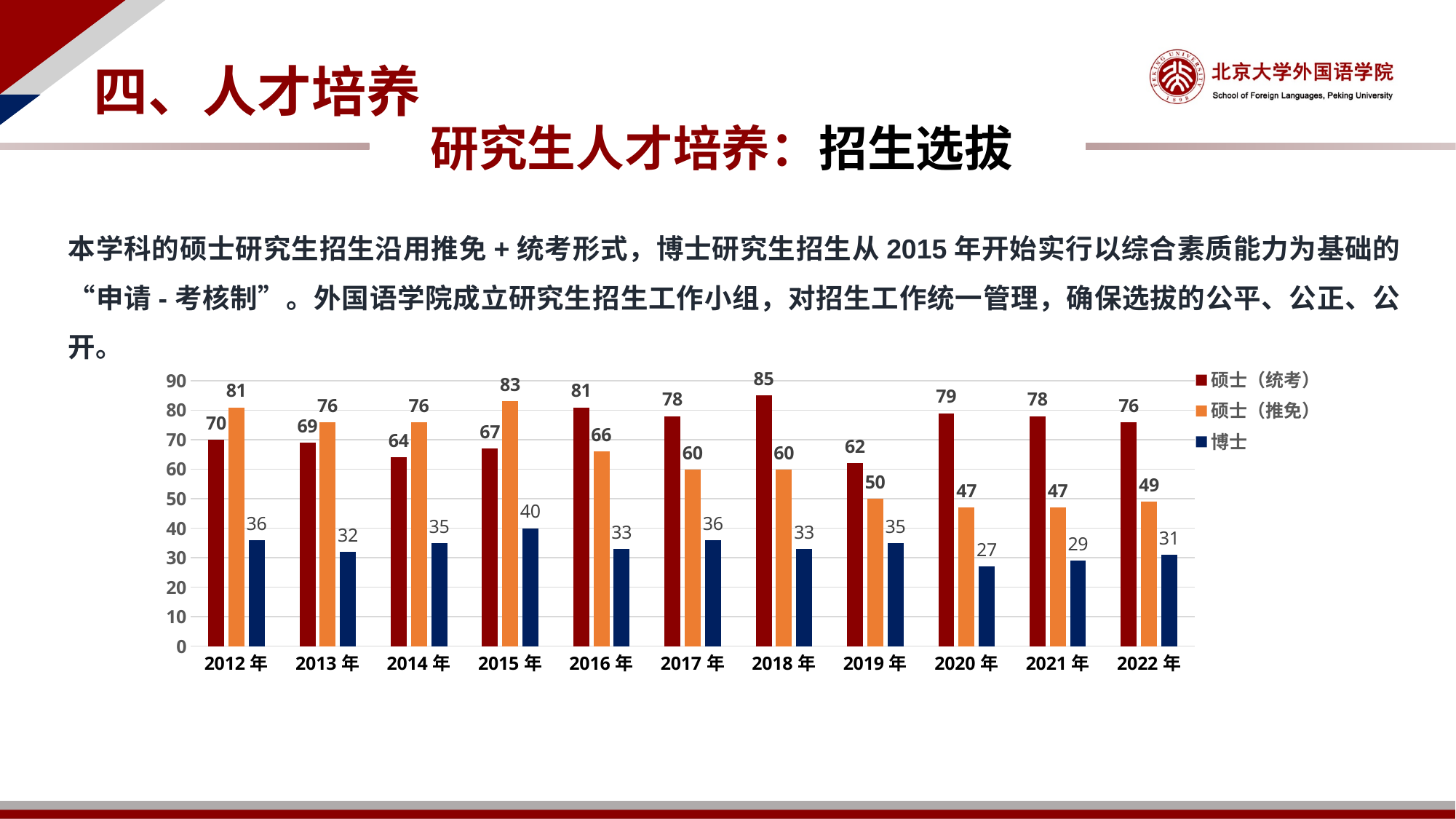
What is the value for 硕士（推免） in 2015 年? 83 Which year has the highest value for 硕士（统考）? 2018 年 What is the difference between 硕士（推免） in 2012 年 and 硕士（推免） in 2022 年? 32 Which is larger in 2016 年: 硕士（统考） or 硕士（推免）? 硕士（统考） What is the value for 硕士（统考） in 2018 年? 85 What kind of chart is shown on the slide? bar chart What is the value for 博士 in 2020 年? 27 Does the value for 硕士（推免） rise or fall from 2015 年 to 2020 年? fall How many series does the legend list? 3 How many years are shown on the x axis? 11 Which year has the lowest value for 博士? 2020 年 Which colour represents 博士 in the legend? dark blue